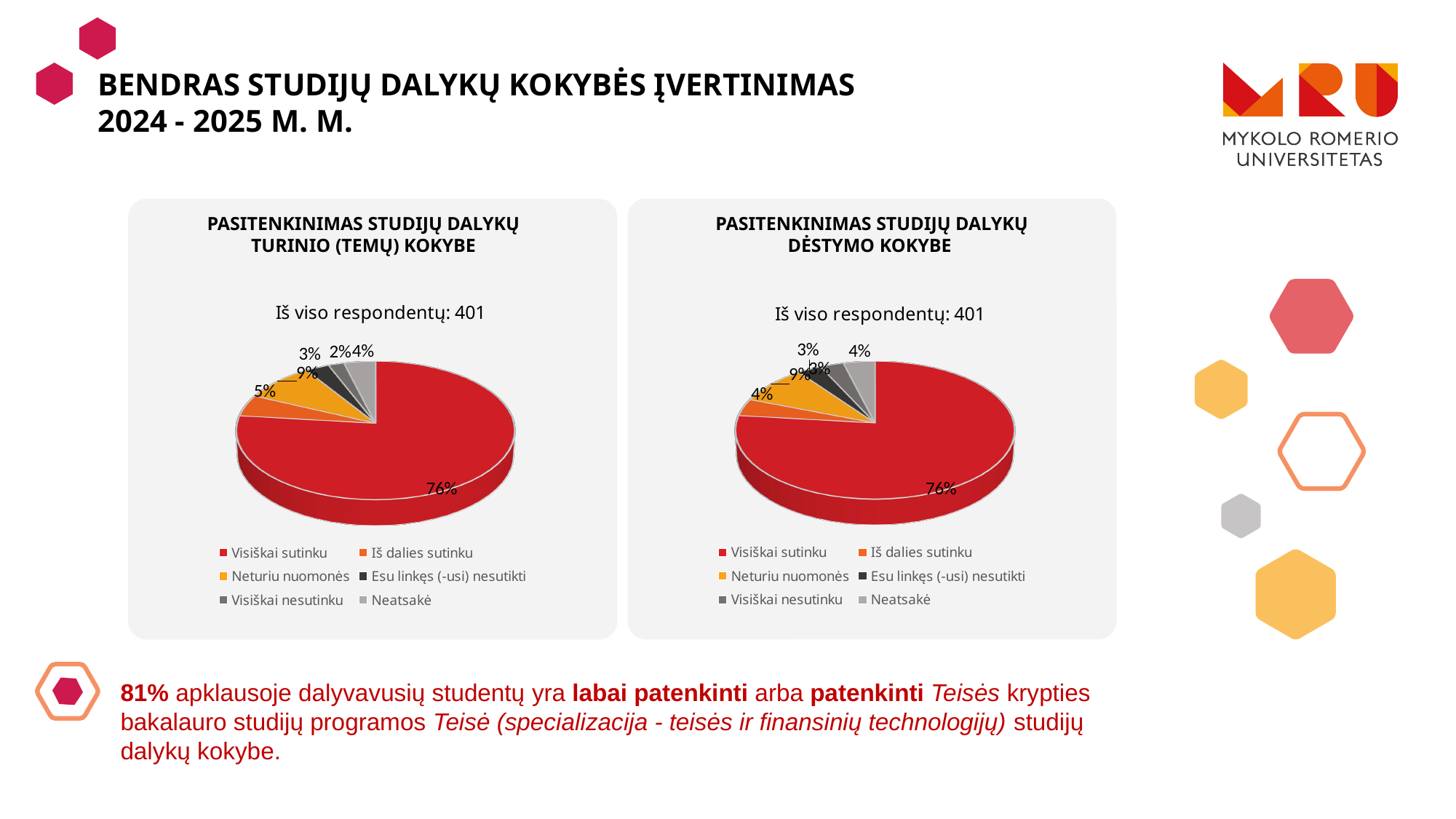
In the right chart (Pasitenkinimas studijų dalykų dėstymo kokybe), what share of respondents chose "Neturiu nuomonės"? 9% What type of chart is used in the right chart (Pasitenkinimas studijų dalykų dėstymo kokybe)? Pie chart How many categories does the legend of the left chart (Pasitenkinimas studijų dalykų turinio (temų) kokybe) list? 6 In the left chart (Pasitenkinimas studijų dalykų turinio (temų) kokybe), what share of respondents chose "Neatsakė"? 4% In the left chart (Pasitenkinimas studijų dalykų turinio (temų) kokybe), which category has the largest slice? Visiškai sutinku In the left chart (Pasitenkinimas studijų dalykų turinio (temų) kokybe), what is the difference between the "Visiškai sutinku" share and the "Neturiu nuomonės" share? 67% In the left chart (Pasitenkinimas studijų dalykų turinio (temų) kokybe), what share of respondents chose "Neturiu nuomonės"? 9% In the right chart (Pasitenkinimas studijų dalykų dėstymo kokybe), what share of respondents chose "Iš dalies sutinku"? 4% In the left chart (Pasitenkinimas studijų dalykų turinio (temų) kokybe), what share of respondents chose "Visiškai sutinku"? 76% In the right chart (Pasitenkinimas studijų dalykų dėstymo kokybe), what share of respondents chose "Visiškai sutinku"? 76% In the left chart (Pasitenkinimas studijų dalykų turinio (temų) kokybe), what share of respondents chose "Iš dalies sutinku"? 5% In the left chart (Pasitenkinimas studijų dalykų turinio (temų) kokybe), which is larger: the "Iš dalies sutinku" share or the "Neturiu nuomonės" share? Neturiu nuomonės